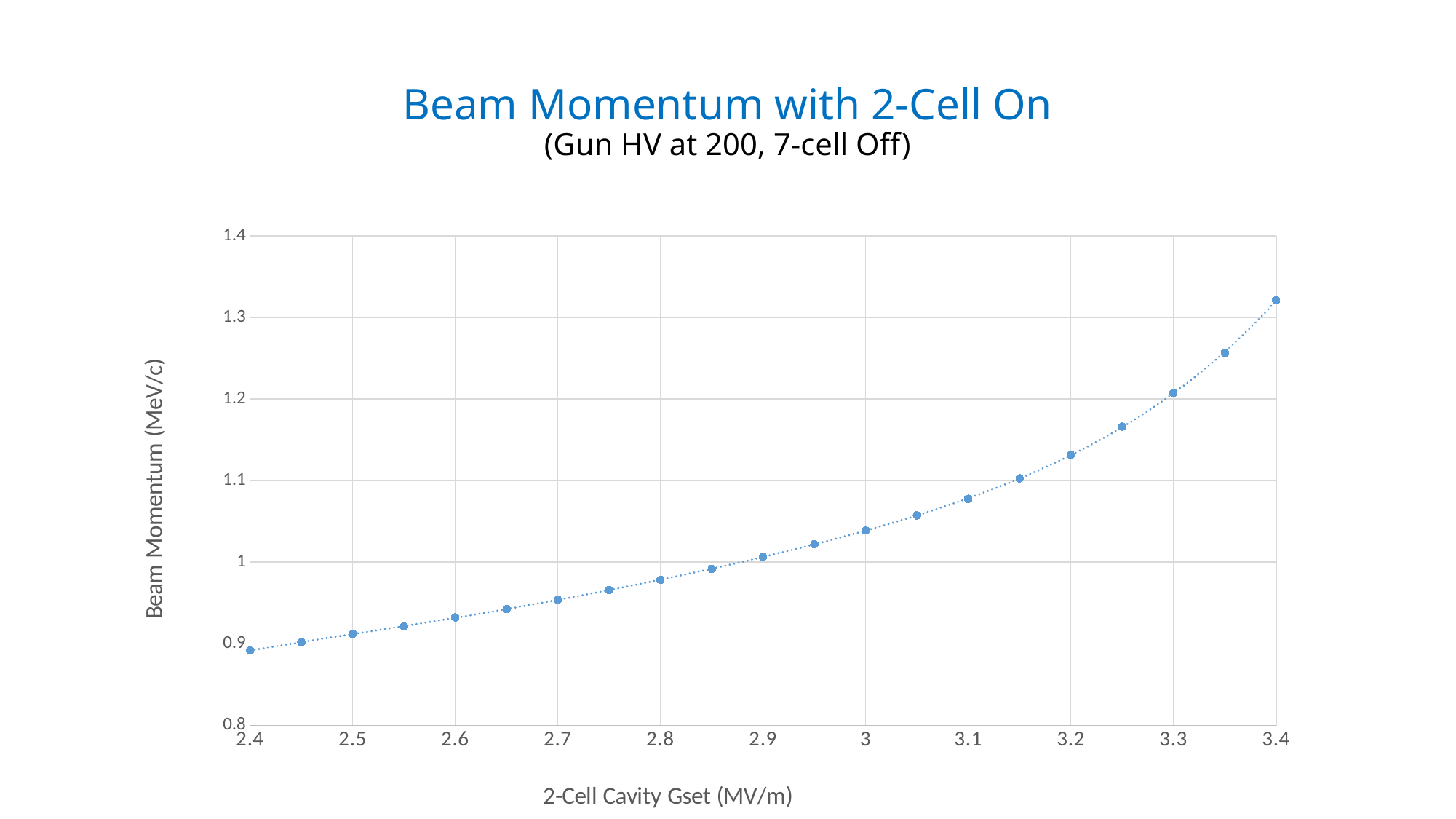
Is the beam momentum at a Gset of 3.2 greater or less than 1.1? greater What is the label of the y axis? Beam Momentum (MeV/c) How many data points are plotted on the chart? 21 What is the title of the chart? Beam Momentum with 2-Cell On Is the beam momentum at a Gset of 3.4 greater or less than 1.3? greater What kind of chart is shown on the slide? line chart Do the beam momentum values rise or fall as the 2-Cell Cavity Gset increases? rise Which has the larger beam momentum, a Gset of 3.3 or a Gset of 2.5? 3.3 At which 2-Cell Cavity Gset value is the beam momentum lowest? 2.4 At which 2-Cell Cavity Gset value is the beam momentum highest? 3.4 Is the beam momentum at a Gset of 3 greater or less than 1? greater